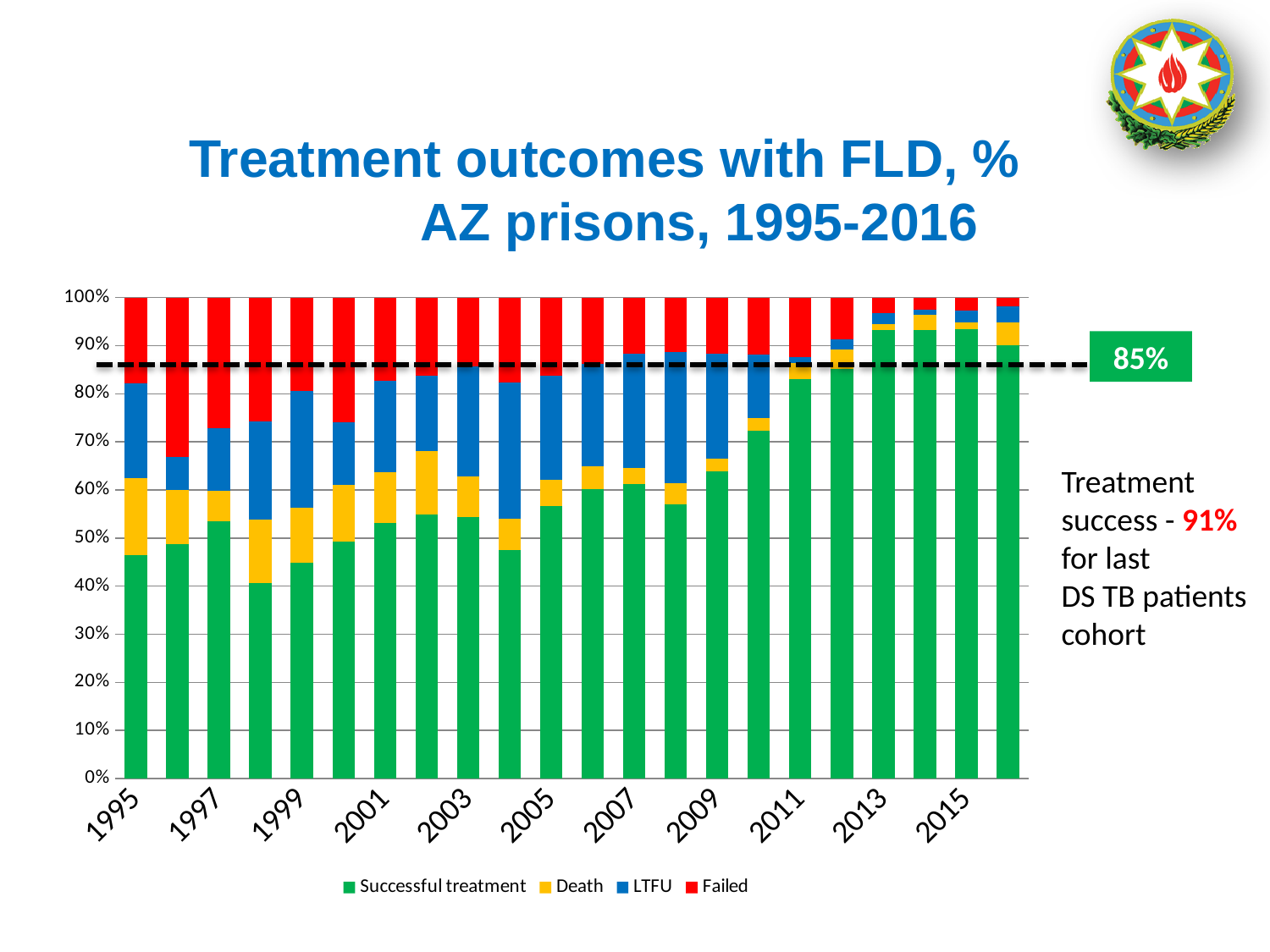
How many years (bars) are plotted in the chart? 22 Is the Successful treatment share for 1995 greater or less than 50%? less What value does the dashed horizontal reference line mark? 85% In which year is the Successful treatment share the lowest? 1998 What kind of chart is shown on the slide? stacked bar chart Does the Successful treatment share generally rise or fall from 1995 to 2016? rise Is the Successful treatment share for 1998 greater or less than 50%? less Is the Successful treatment share for 2013 greater or less than 90%? greater Which year has a larger Successful treatment share, 1995 or 2016? 2016 In which year is the Failed share the largest? 1996 How many series does the legend list? 4 According to the text beside the chart, what was the treatment success for the last DS TB patients cohort? 91%